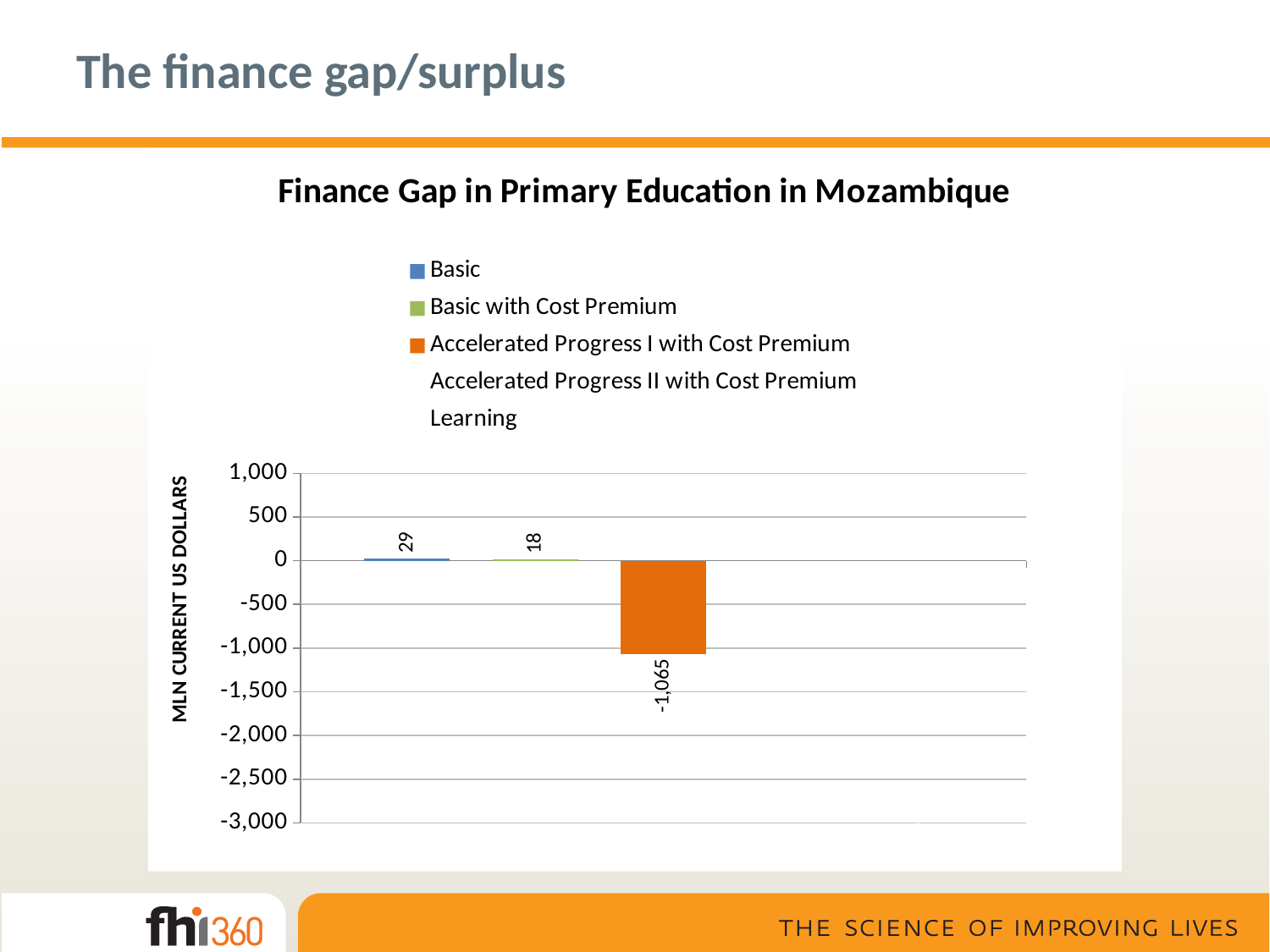
Is the value for Accelerated Progress I with Cost Premium greater or less than -1,000? less What is the title of the chart? Finance Gap in Primary Education in Mozambique What is the difference between the values for Basic and Basic with Cost Premium? 11 What is the value for Accelerated Progress I with Cost Premium? -1,065 What kind of chart is shown on the slide? bar chart What is the value for Basic in the Finance Gap in Primary Education in Mozambique chart? 29 How many series does the legend list? 5 What is the value for Basic with Cost Premium? 18 Which is larger, the value for Basic or the value for Basic with Cost Premium? Basic Which series has the highest value in the chart? Basic What is the label of the vertical axis? MLN CURRENT US DOLLARS